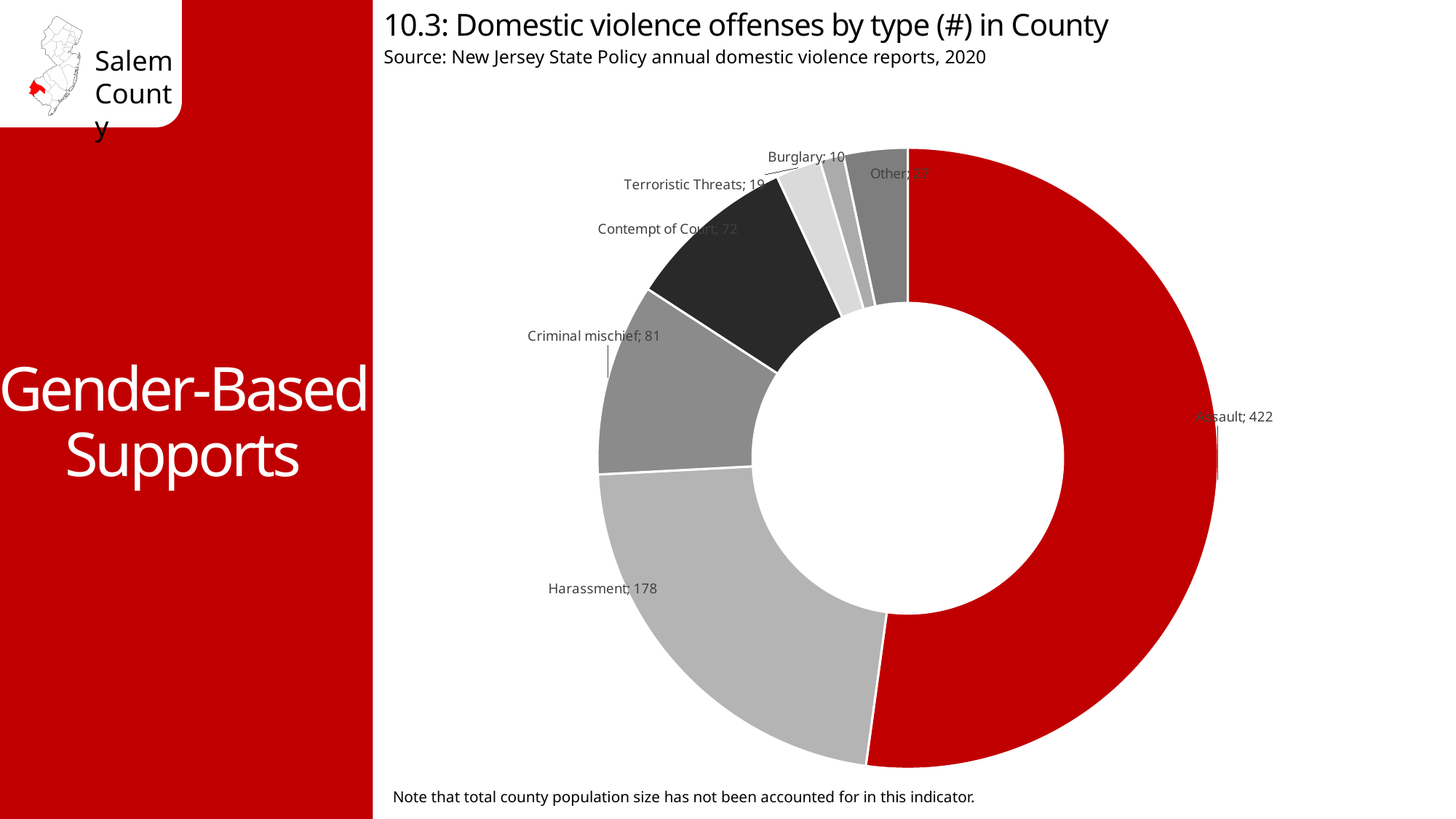
How many domestic violence offenses of type Assault are shown on the chart? 422 What is the difference between the Assault and Harassment values? 244 Which offense type has the highest number of offenses? Assault Which is larger, the value for Other or the value for Terroristic Threats? Other What is the value shown for Criminal mischief? 81 What is the value shown for Harassment? 178 What is the value shown for Burglary? 10 How many offense types (slices) are shown on the chart? 7 What is the source cited for the chart? New Jersey State Policy annual domestic violence reports, 2020 What kind of chart is shown on the slide? Doughnut chart Which offense type has the lowest number of offenses? Burglary What is the value shown for Contempt of Court? 72